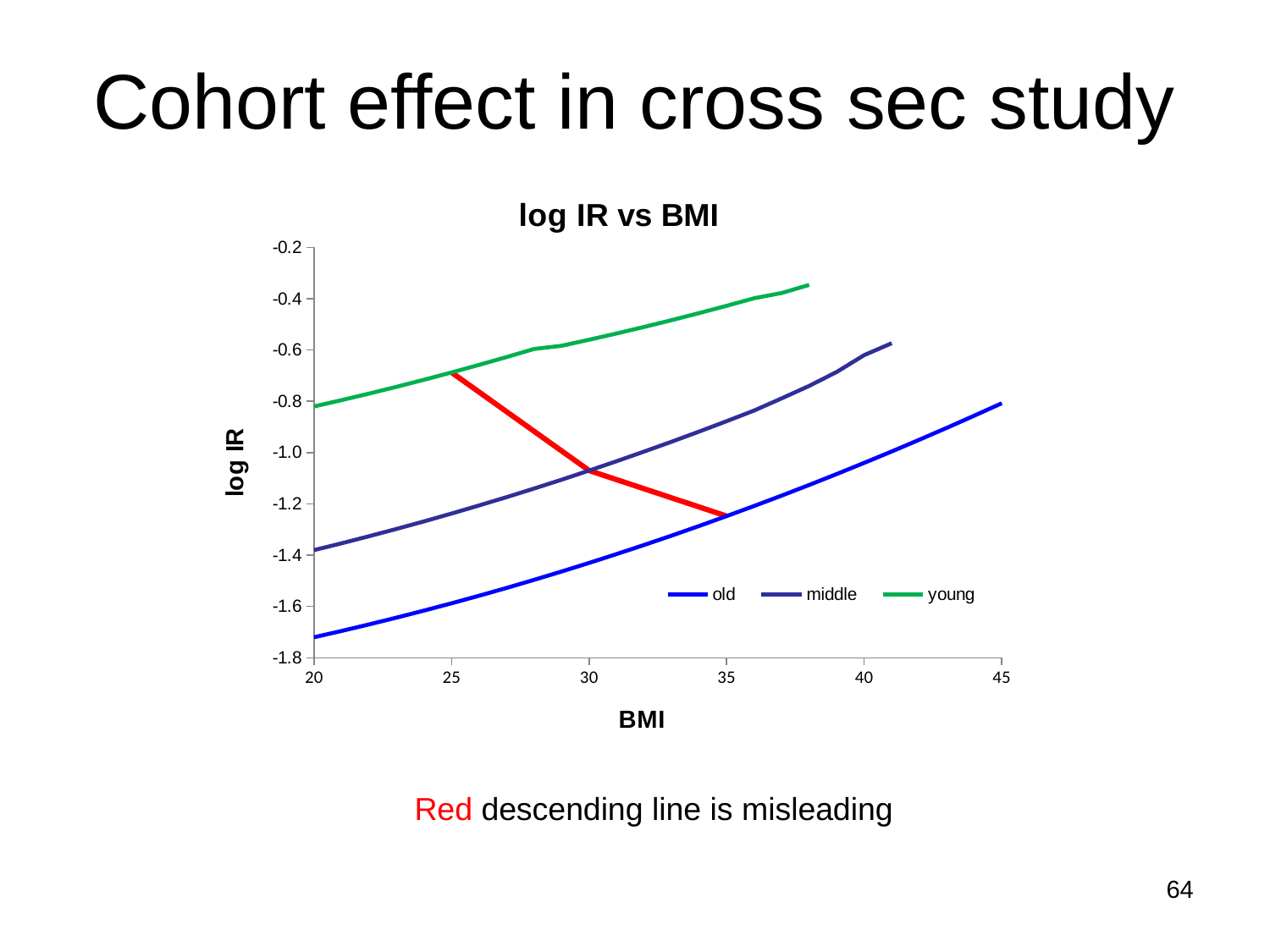
What kind of chart is shown on the slide? line chart Is the log IR for the 'old' series at BMI 20 greater or less than -1.6? less Which series has the lowest log IR values across the BMI range? old Does the red line rise or fall as BMI increases? fall Is the log IR for the 'middle' series at BMI 20 greater or less than -1.2? less At BMI 30, which series has the larger log IR, 'young' or 'middle'? young What is the title of the chart? log IR vs BMI How many series does the legend list? 3 Which series has the highest log IR values across the BMI range? young What is the label of the x axis? BMI Is the log IR for the 'young' series at BMI 20 greater or less than -1.0? greater Does the log IR for the 'old' series rise or fall as BMI increases? rise